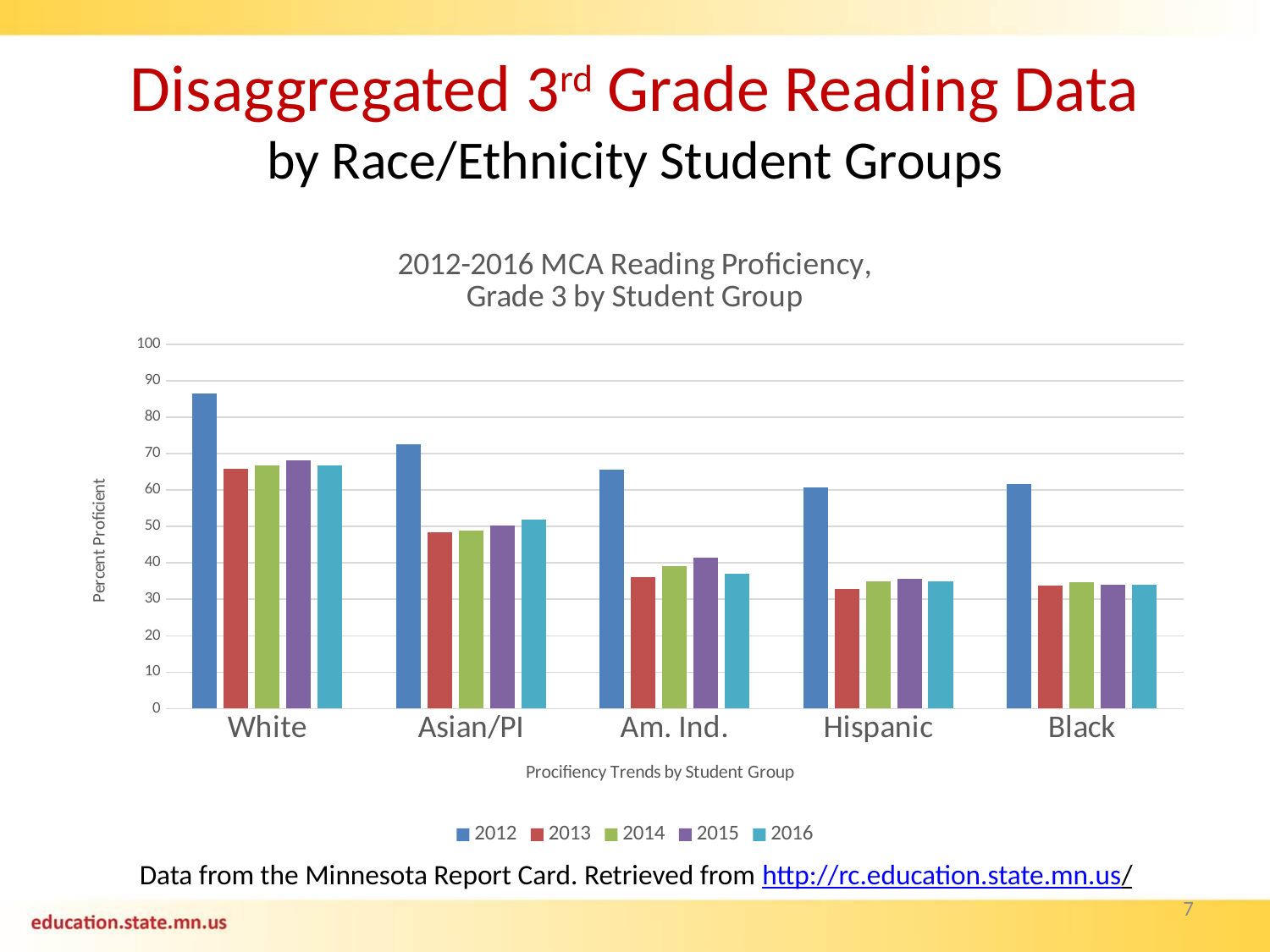
Which student group has the highest 2012 value? White What is the label on the chart's vertical axis? Percent Proficient How many series does the chart's legend list? 5 Is the 2013 value for Hispanic greater or less than 40? less Does the value for Am. Ind. rise or fall from 2012 to 2013? fall Is the 2012 value for Asian/PI greater or less than 70? greater Is the 2012 value for White greater or less than 80? greater How many student groups are shown on the x axis of the chart? 5 What kind of chart is shown on the slide? bar chart Which is larger, the 2016 value for White or the 2016 value for Asian/PI? White Which is larger, the 2015 value for Am. Ind. or the 2015 value for Hispanic? Am. Ind.